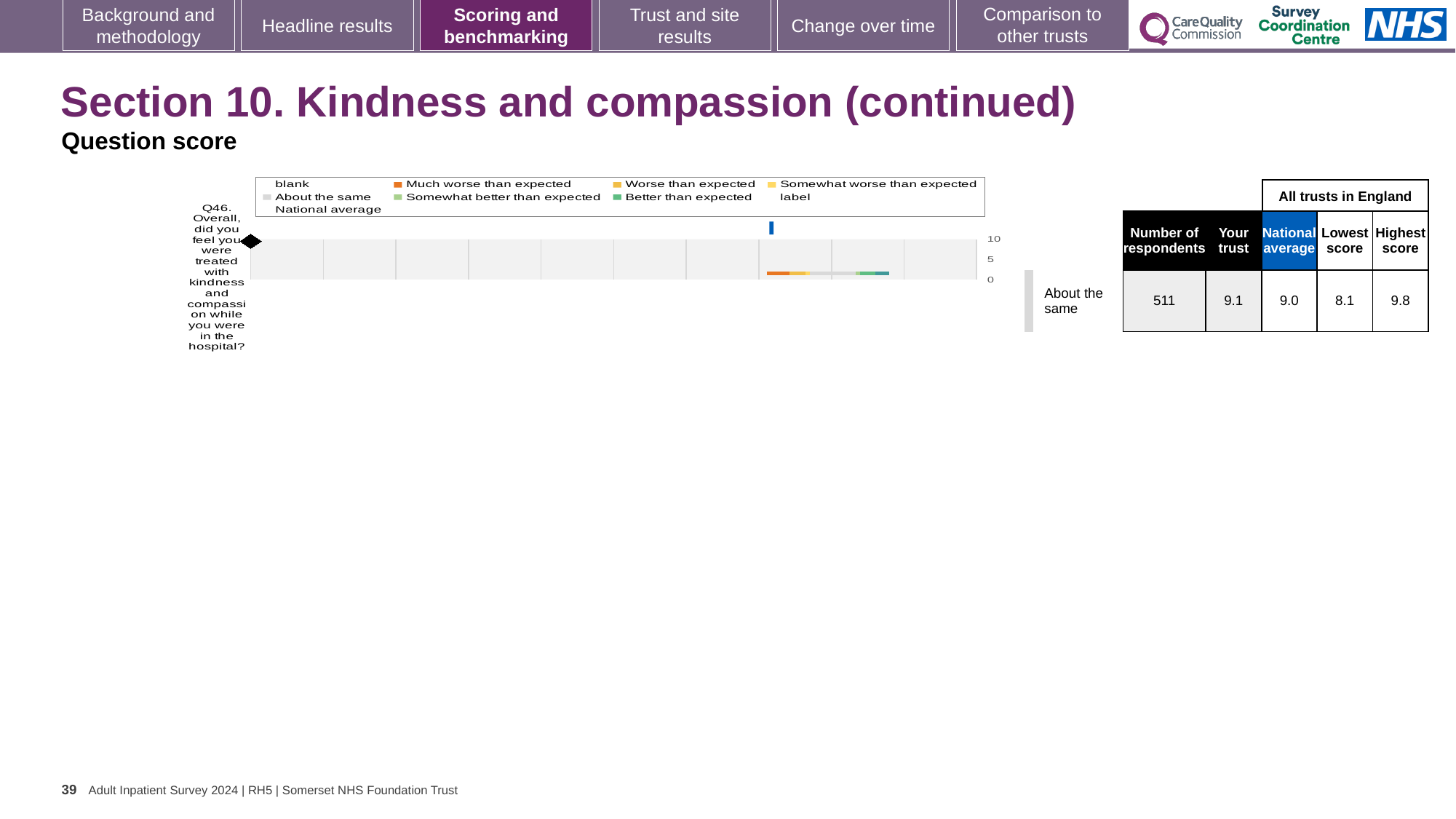
Which is larger for Q46 in the table next to the chart: the Your trust score or the National average? Your trust According to the table next to the chart, what is the score for Your trust on Q46? 9.1 According to the table next to the chart, how many respondents answered Q46? 511 What is the highest value shown on the chart's numeric axis? 10 According to the table next to the chart, what is the National average score for Q46? 9.0 According to the table next to the chart, what is the Highest score among all trusts in England for Q46? 9.8 What is the difference between the Highest score and the Lowest score for Q46 in the table next to the chart? 1.7 What benchmarking category is the trust's Q46 result labelled as on the slide? About the same Which question is plotted on the chart? Q46. Overall, did you feel you were treated with kindness and compassion while you were in the hospital? According to the table next to the chart, what is the Lowest score among all trusts in England for Q46? 8.1 What kind of chart is shown on the slide? bar chart How many questions (categories) are plotted on the chart? 1